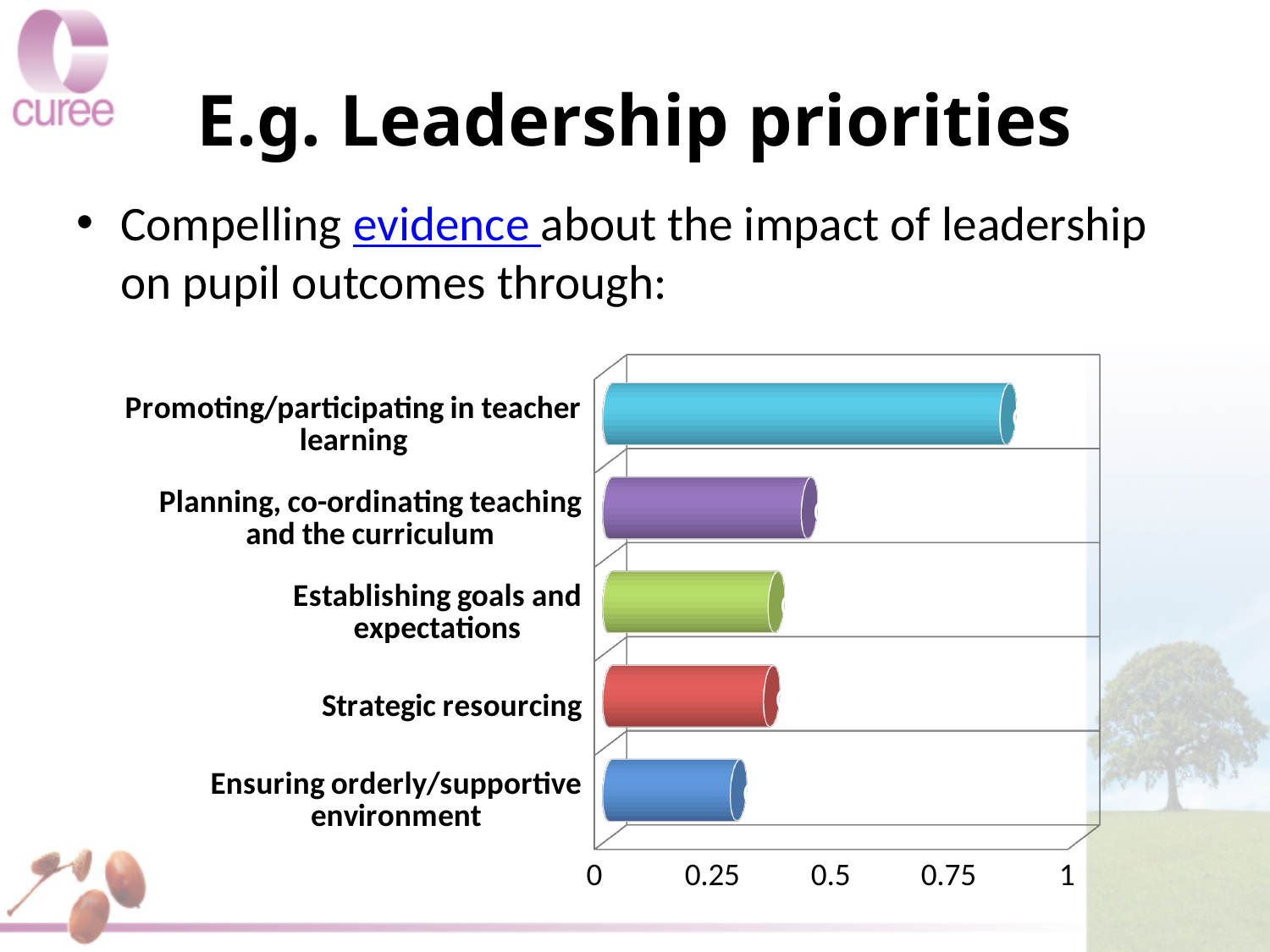
What kind of chart is shown on the slide? Bar chart Which category has the lowest value in the chart? Ensuring orderly/supportive environment Which is larger: the value for Promoting/participating in teacher learning or the value for Planning, co-ordinating teaching and the curriculum? Promoting/participating in teacher learning What is the highest value shown on the chart's horizontal axis? 1 Which category has the highest value in the chart? Promoting/participating in teacher learning Which is larger: the value for Planning, co-ordinating teaching and the curriculum or the value for Ensuring orderly/supportive environment? Planning, co-ordinating teaching and the curriculum Is the value for Planning, co-ordinating teaching and the curriculum greater or less than 0.5? less What colour is the bar for Strategic resourcing? Red Is the value for Promoting/participating in teacher learning greater or less than 0.75? greater How many categories are plotted in the chart? 5 Is the value for Establishing goals and expectations greater or less than 0.5? less